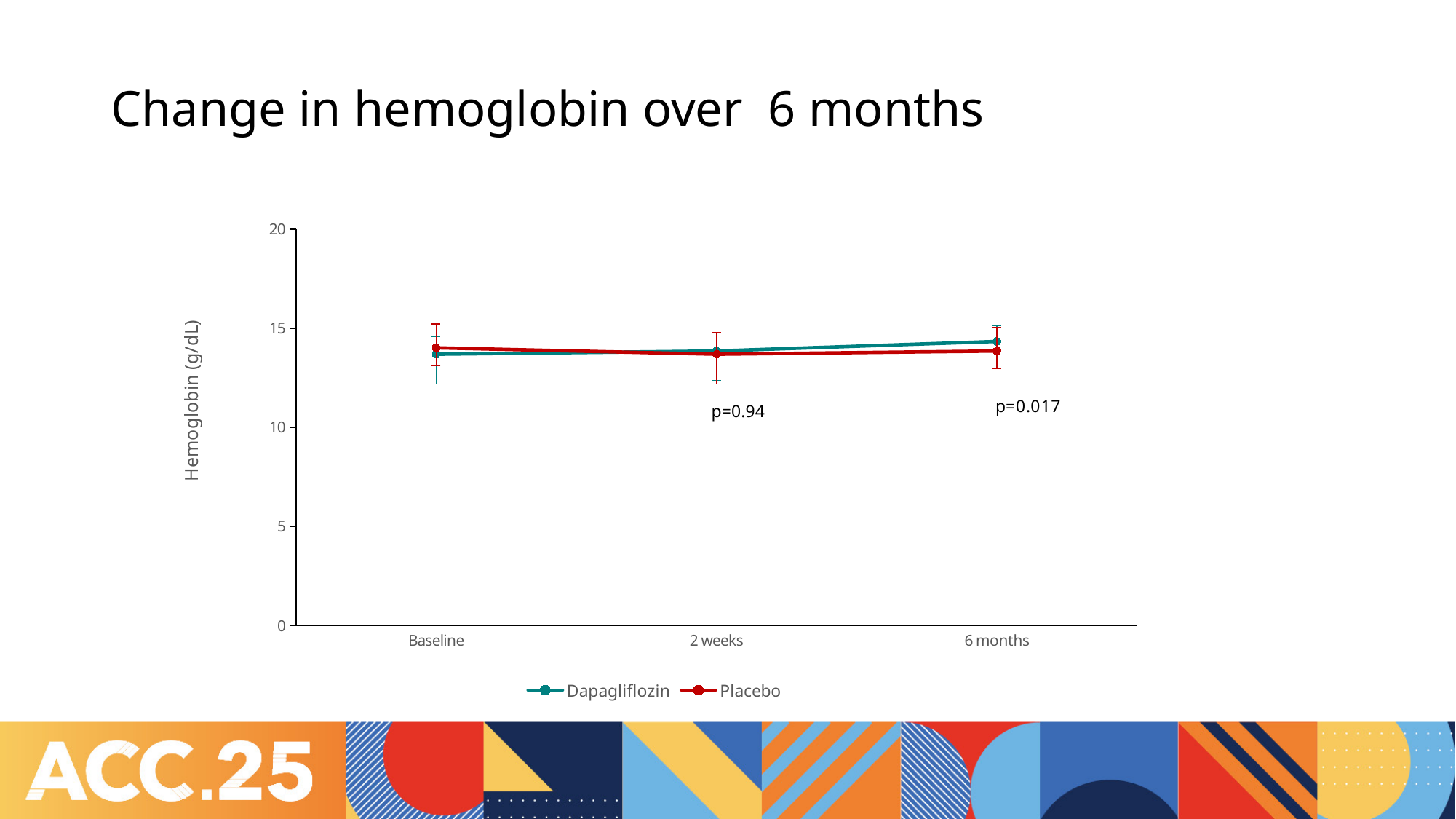
What p-value is shown at the 6 months time point? p=0.017 What p-value is shown at the 2 weeks time point? p=0.94 Which series is higher at 6 months, Dapagliflozin or Placebo? Dapagliflozin How many series does the legend list? 2 Is the value for Placebo at Baseline greater or less than 10? greater What kind of chart is shown on the slide? Line chart Is the value for Dapagliflozin at 2 weeks greater or less than 10? greater At which time point is the Dapagliflozin value highest? 6 months Does the Dapagliflozin line rise or fall from Baseline to 6 months? rise How many time points are plotted along the x axis? 3 Is the value for Dapagliflozin at 6 months greater or less than 15? less